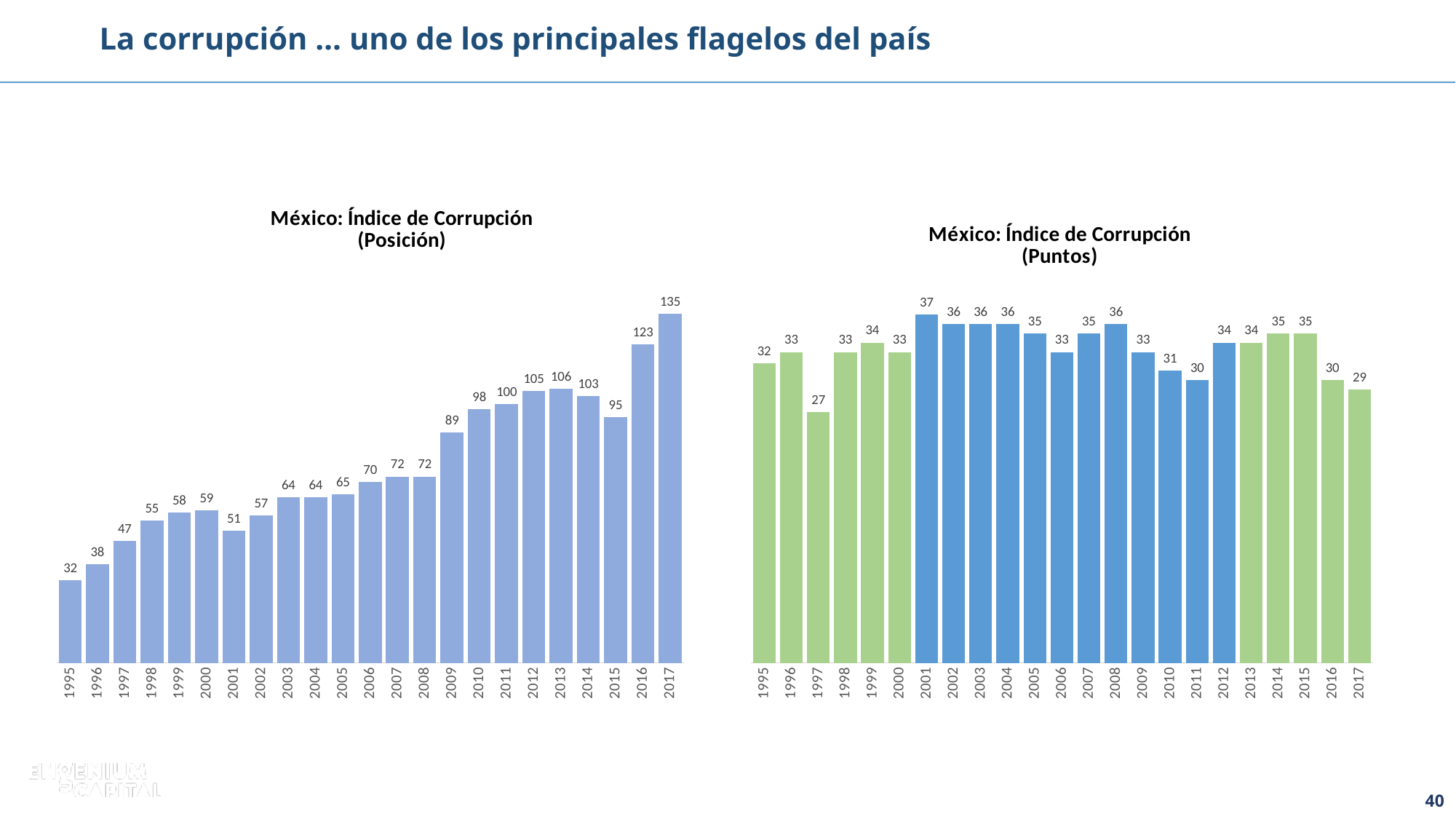
What type of chart is the 'México: Índice de Corrupción (Puntos)' chart? bar chart In the 'México: Índice de Corrupción (Puntos)' chart, what is the difference between the values for 2001 and 2017? 8 In the 'México: Índice de Corrupción (Posición)' chart, do the values generally rise or fall from 1995 to 2017? rise In the 'México: Índice de Corrupción (Puntos)' chart, which year has the highest value? 2001 In the 'México: Índice de Corrupción (Posición)' chart, which year has the lowest value? 1995 In the 'México: Índice de Corrupción (Puntos)' chart, which is larger, the value for 2008 or the value for 2011? 2008 In the 'México: Índice de Corrupción (Posición)' chart, what is the value for 2009? 89 In the 'México: Índice de Corrupción (Puntos)' chart, what colour are the bars for 2001 through 2012? blue In the 'México: Índice de Corrupción (Posición)' chart, what is the value for 2017? 135 In the 'México: Índice de Corrupción (Posición)' chart, how many years are shown on the x axis? 23 In the 'México: Índice de Corrupción (Puntos)' chart, what is the value for 1997? 27 In the 'México: Índice de Corrupción (Posición)' chart, what is the difference between the values for 2017 and 2016? 12